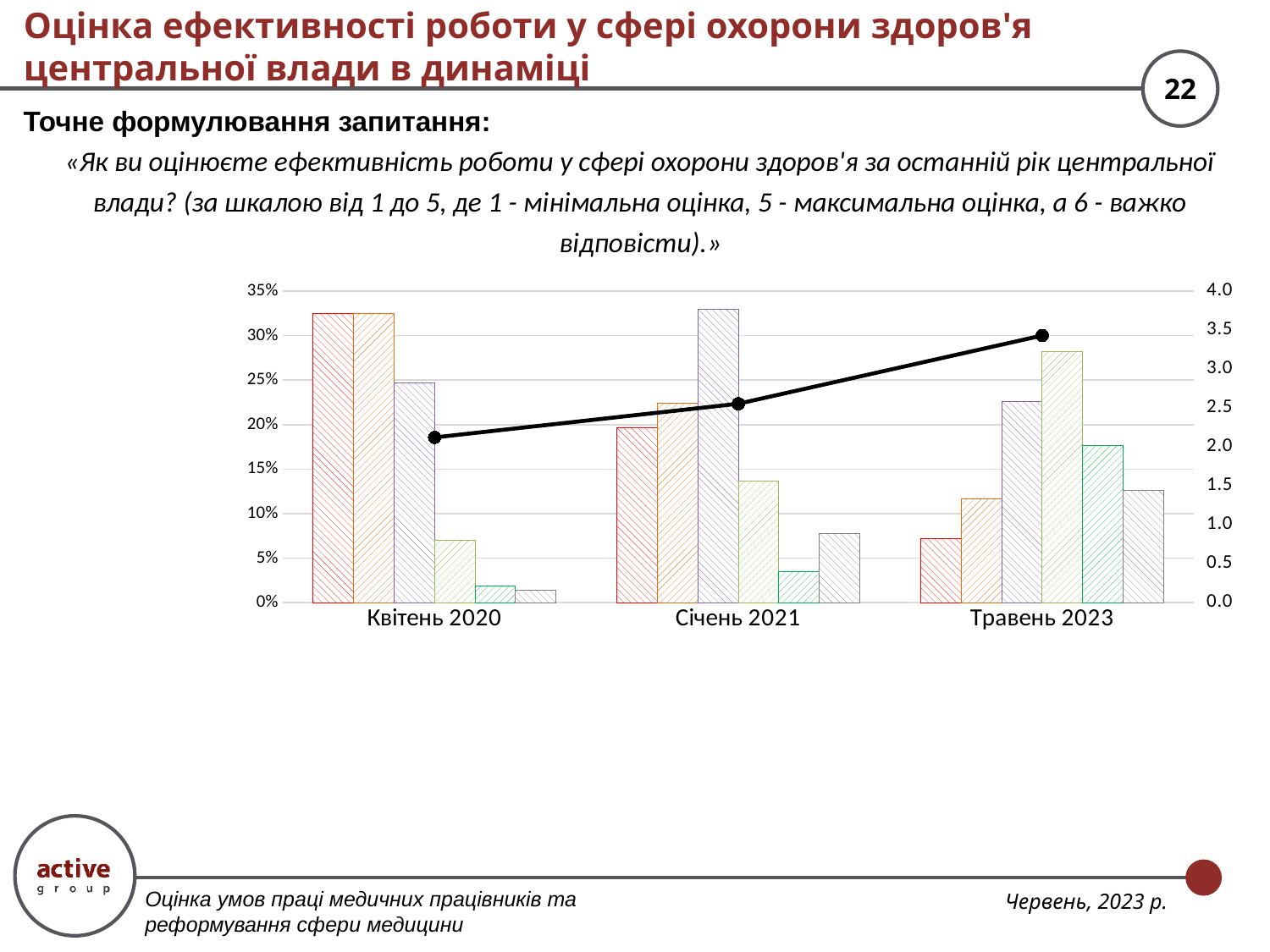
Is the value of the black line for Травень 2023 greater or less than 3.0 on the right axis? greater How many time-period categories are shown on the x axis? 3 Is the leftmost bar for Травень 2023 greater or less than 10%? less Does the black line rise or fall from Квітень 2020 to Травень 2023? rises What is the maximum value shown on the right vertical axis? 4.0 Is the value of the black line for Квітень 2020 greater or less than 2.5 on the right axis? less What kind of chart is shown on the slide? A bar chart combined with a line What is the maximum value shown on the left vertical axis? 35% How many bars are plotted for each time-period category? 6